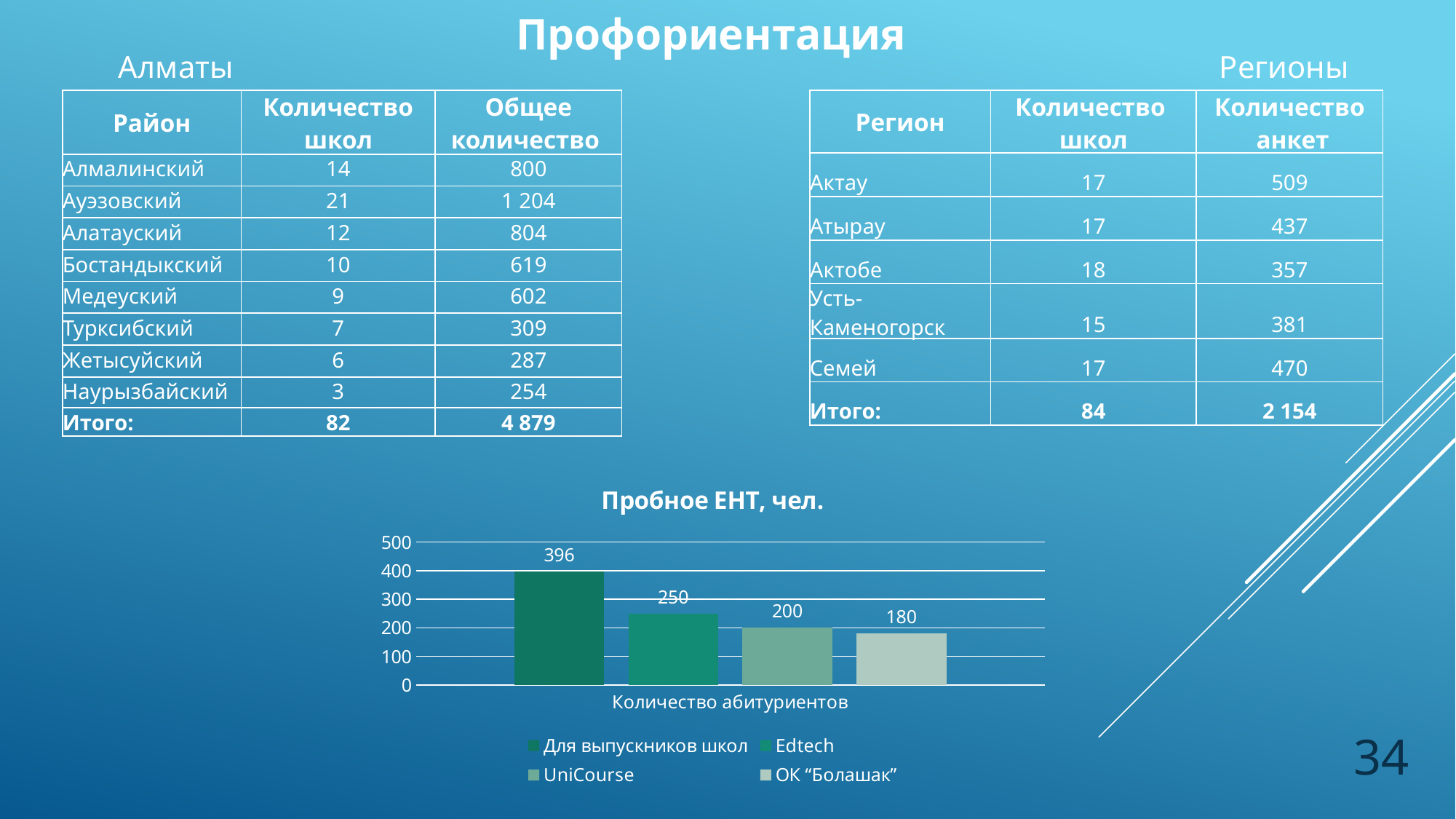
Which series has the highest value in the chart "Пробное ЕНТ, чел."? Для выпускников школ Which series has the lowest value in the chart? ОК "Болашак" How many series does the legend of the chart list? 4 What is the title of the chart on the slide? Пробное ЕНТ, чел. What is the value for "Для выпускников школ" in the chart? 396 What is the value for ОК "Болашак" in the chart? 180 What kind of chart is shown on the slide? Bar chart What is the value for UniCourse in the chart? 200 What is the difference between the values for UniCourse and ОК "Болашак"? 20 What is the difference between the values for "Для выпускников школ" and Edtech? 146 Which is larger, the value for Edtech or the value for UniCourse? Edtech What is the value for Edtech in the chart "Пробное ЕНТ, чел."? 250